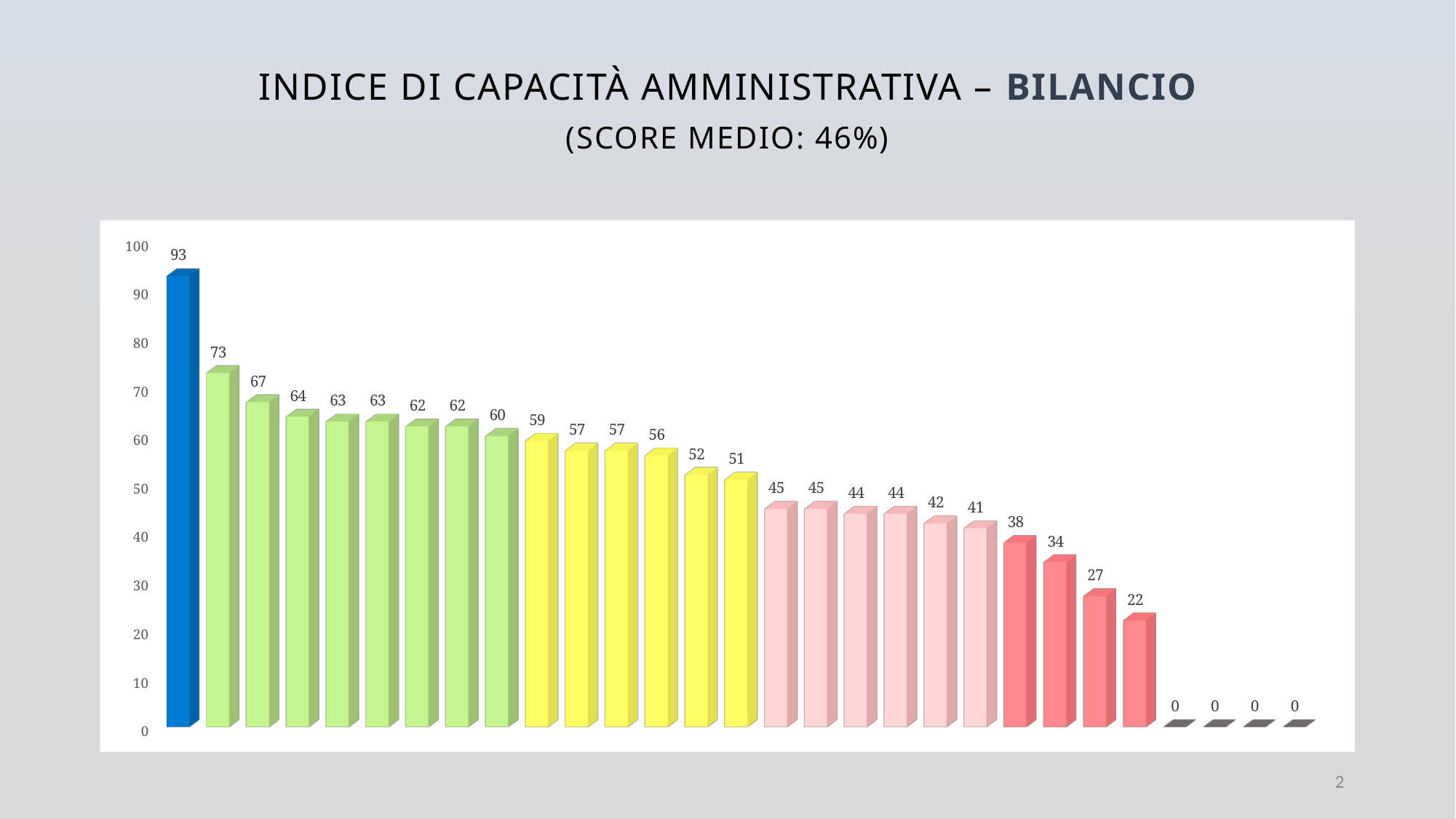
What colour is the tallest bar in the chart? blue What kind of chart is shown on the slide? bar chart What is the value of the first (leftmost) bar in the chart? 93 What is the difference between the first bar (93) and the second bar (73)? 20 What is the value of the second bar from the left in the chart? 73 Do the values rise or fall moving from left to right along the x axis? fall Is the value of the third bar from the left greater or less than 60? greater What is the highest value shown in the chart? 93 How many bars in the chart have a value of 0? 4 What is the lowest value shown in the chart? 0 What is the average score (score medio) stated in the slide title? 46% How many bars are plotted in the chart, including those with a value of 0? 29